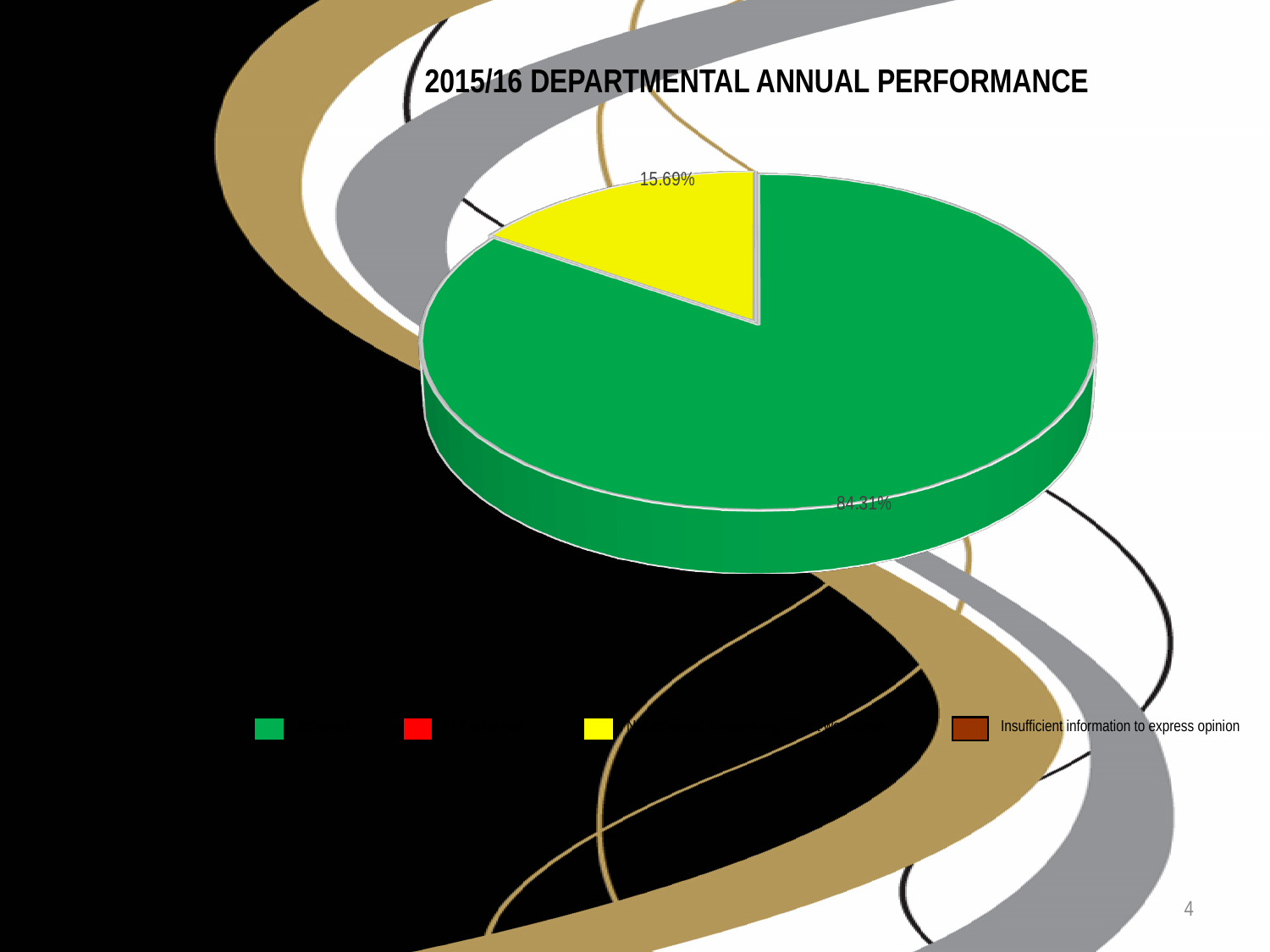
Which slice of the pie is the smallest? the yellow slice Which slice of the pie is the largest? the green slice How many entries does the legend below the chart show? 4 How many slices are visible in the pie chart? 2 What is the title of the chart? 2015/16 DEPARTMENTAL ANNUAL PERFORMANCE What do the two labelled slices of the pie add up to? 100% What percentage is shown for the green slice of the pie? 84.31% What kind of chart is shown on the slide? pie chart What is the difference in percentage points between the green slice and the yellow slice? 68.62% What label is shown next to the brown legend entry? Insufficient information to express opinion Which is larger, the green slice or the yellow slice? the green slice What percentage is shown for the yellow slice of the pie? 15.69%